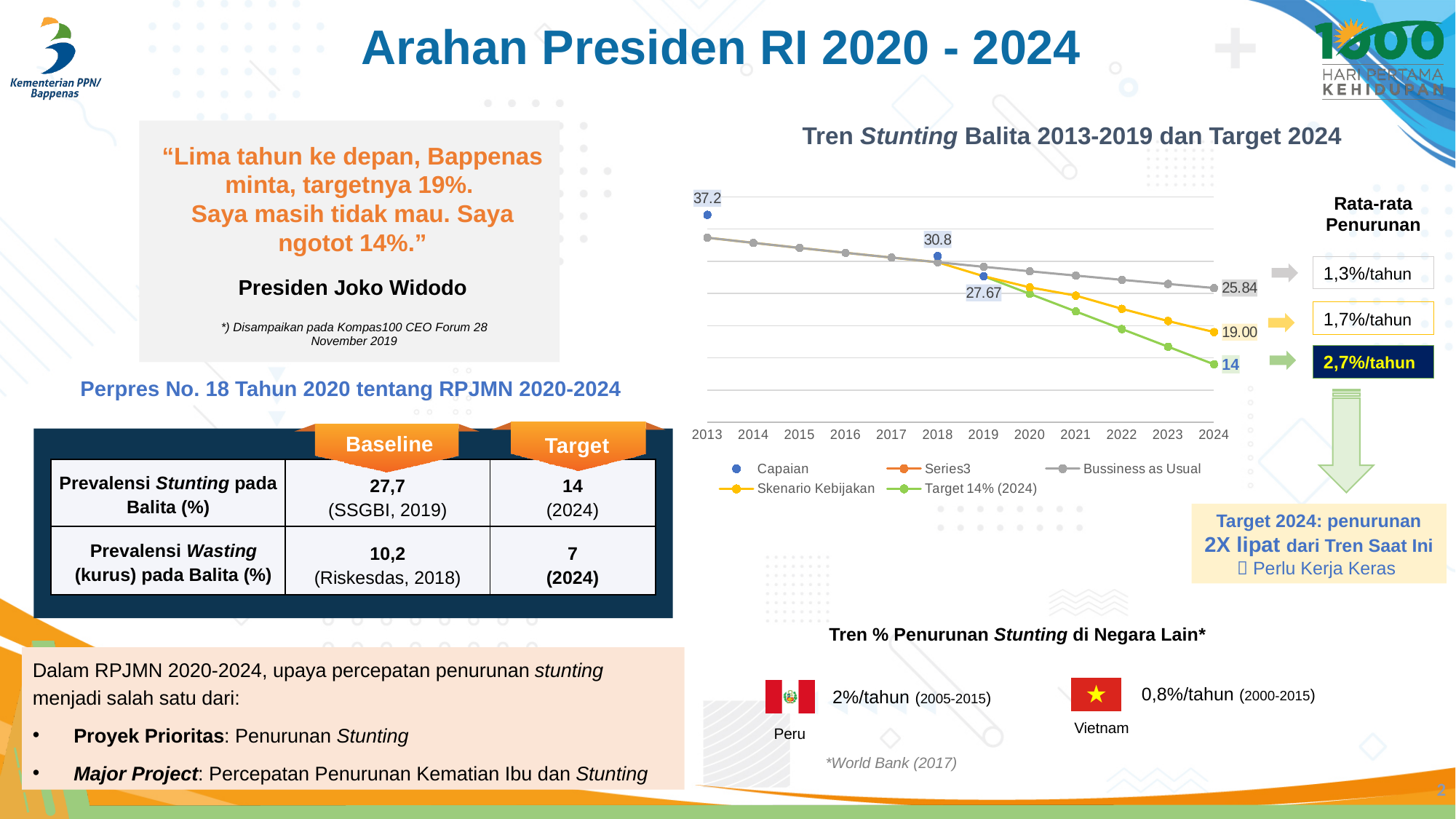
How many years are shown on the x axis of the chart 'Tren Stunting Balita 2013-2019 dan Target 2024'? 12 In the chart 'Tren Stunting Balita 2013-2019 dan Target 2024', what is the Bussiness as Usual value for 2024? 25.84 In the chart 'Tren Stunting Balita 2013-2019 dan Target 2024', what is the difference between the Capaian values for 2013 and 2018? 6.4 In the chart 'Tren Stunting Balita 2013-2019 dan Target 2024', what is the Capaian value for 2019? 27.67 In the chart 'Tren Stunting Balita 2013-2019 dan Target 2024', which 2024 value is larger: Bussiness as Usual or Skenario Kebijakan? Bussiness as Usual What type of chart is used for 'Tren Stunting Balita 2013-2019 dan Target 2024'? line chart In the chart 'Tren Stunting Balita 2013-2019 dan Target 2024', what is the Capaian value for 2013? 37.2 In the chart 'Tren Stunting Balita 2013-2019 dan Target 2024', what is the Capaian value for 2018? 30.8 In the chart 'Tren Stunting Balita 2013-2019 dan Target 2024', do the Capaian values rise or fall from 2013 to 2019? fall In the chart 'Tren Stunting Balita 2013-2019 dan Target 2024', what is the Skenario Kebijakan value for 2024? 19.00 In the chart 'Tren Stunting Balita 2013-2019 dan Target 2024', what is the Target 14% (2024) value for 2024? 14 How many series does the legend of the chart 'Tren Stunting Balita 2013-2019 dan Target 2024' list? 5